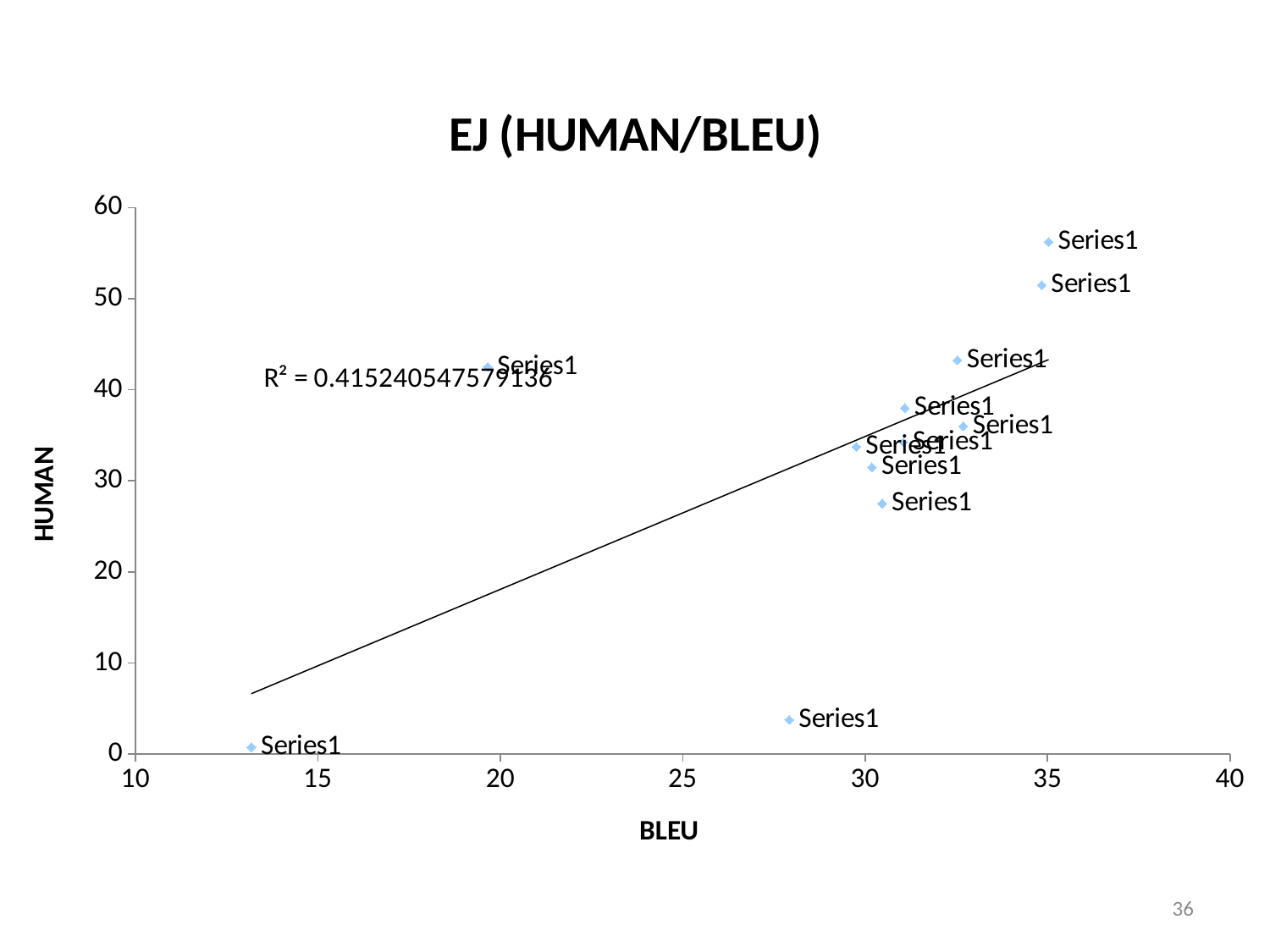
What kind of chart is shown on the slide? scatter chart What R² value is printed on the chart? R² = 0.415240547579136 Is the HUMAN value of the point near BLEU 28 greater or less than 10? less Is the HUMAN value of the point with the lowest BLEU score (near BLEU 13) greater or less than 10? less What is the maximum value shown on the BLEU axis? 40 Is the HUMAN value of the highest point greater or less than 50? greater Which has the higher HUMAN value: the point near BLEU 35 or the point near BLEU 28? the point near BLEU 35 What is the title of the chart? EJ (HUMAN/BLEU) What is the maximum value shown on the HUMAN axis? 60 What is the label of the horizontal axis? BLEU Does the fitted trendline rise or fall as BLEU increases? rise